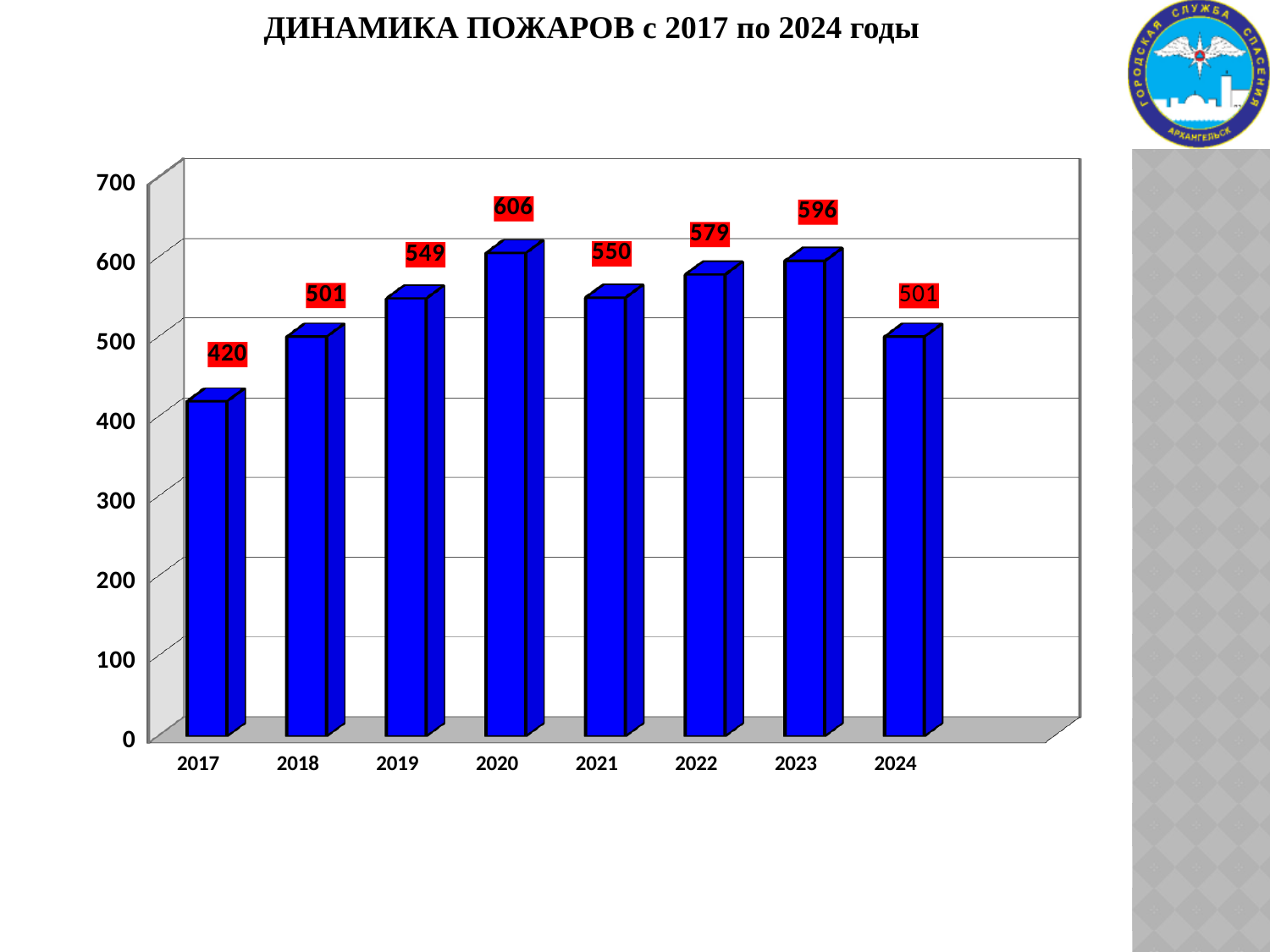
How many years are shown on the x axis? 8 What is the title of the chart? ДИНАМИКА ПОЖАРОВ с 2017 по 2024 годы Which year has the highest value? 2020 Which year has the lowest value? 2017 What is the value for 2020? 606 What is the difference between the values for 2020 and 2017? 186 What is the value for 2022? 579 What kind of chart is shown on the slide? bar chart What is the value for 2017? 420 Which is larger, the value for 2019 or the value for 2021? 2021 Is the value for 2018 greater or less than 400? greater What is the difference between the values for 2023 and 2024? 95